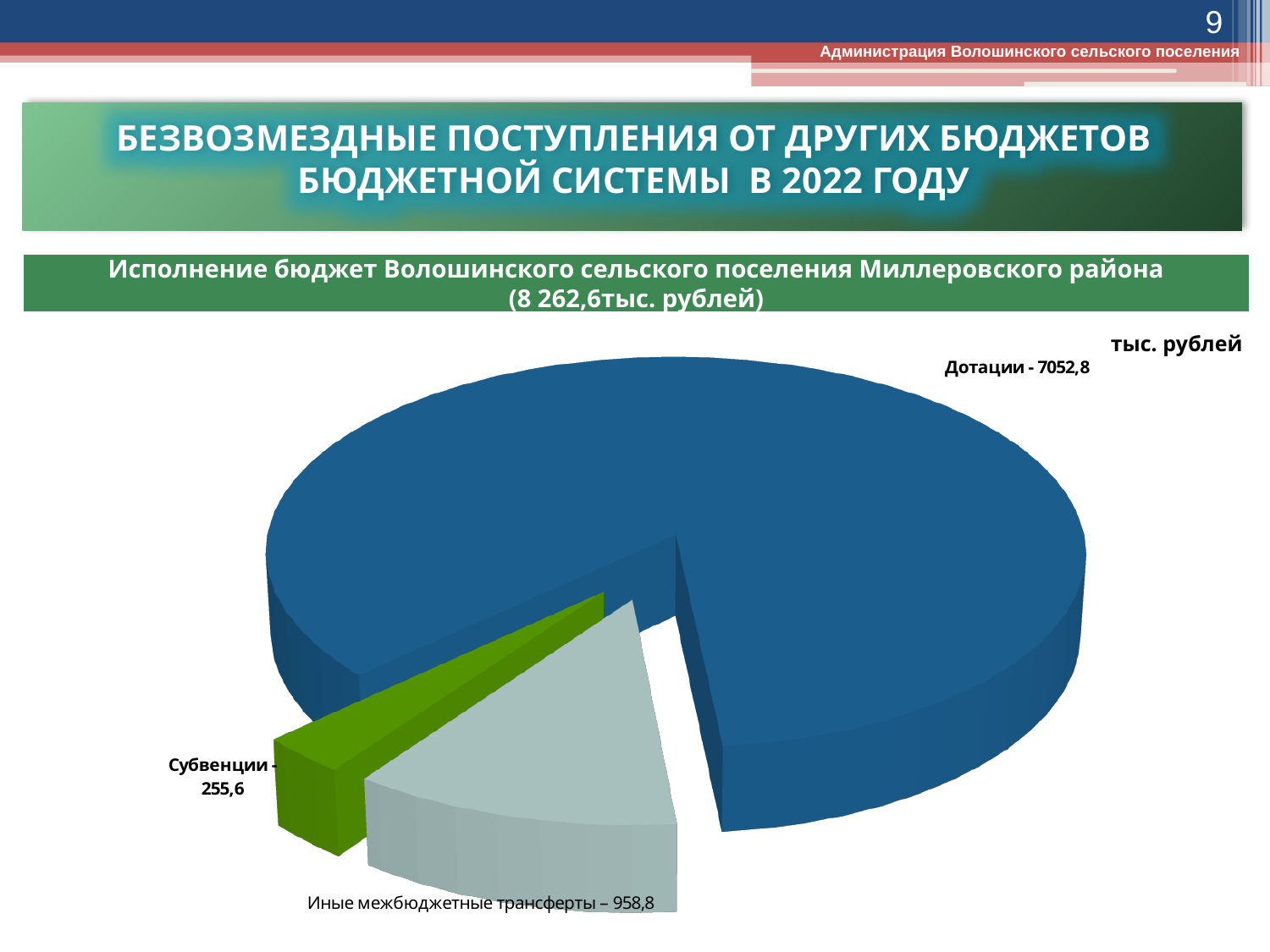
Which is larger, the value for Иные межбюджетные трансферты or the value for Субвенции? Иные межбюджетные трансферты What colour is the slice for Субвенции? Green How many slices does the pie chart have? 3 What is the difference between the values for Иные межбюджетные трансферты and Субвенции? 703,2 What is the difference between the values for Дотации and Иные межбюджетные трансферты? 6094,0 What is the value for Дотации? 7052,8 What is the value for Иные межбюджетные трансферты? 958,8 What unit is stated for the values in the chart? тыс. рублей Which category has the smallest slice of the pie? Субвенции What kind of chart is shown on the slide? Pie chart What is the value for Субвенции? 255,6 Which category has the largest slice of the pie? Дотации